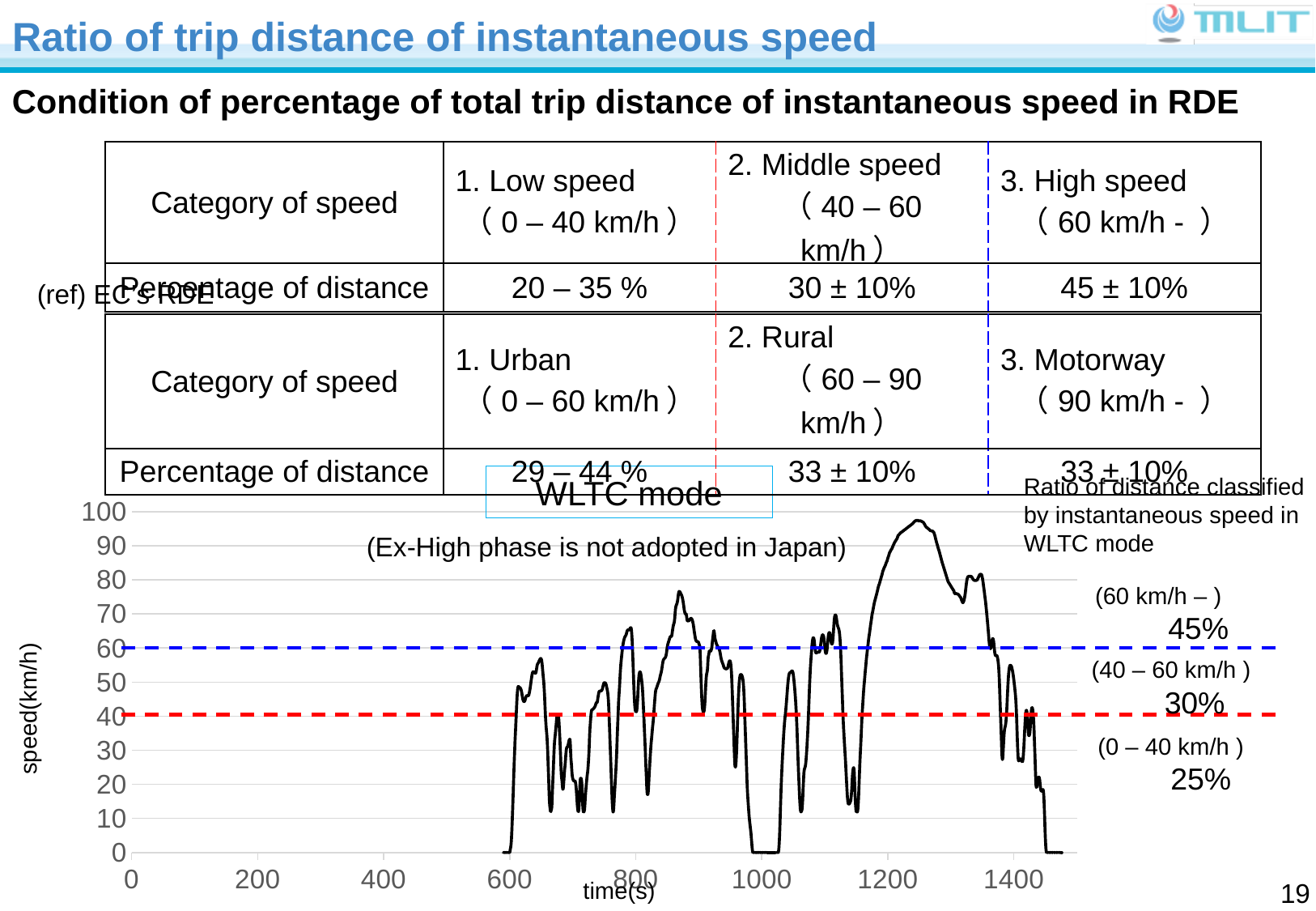
At what speed value is the blue dashed horizontal line drawn on the chart? 60 What is the difference between the ratio of distance for the 60 km/h and above range and the 0 – 40 km/h range in WLTC mode? 20% What is the label of the horizontal axis of the chart? time(s) What is the label of the vertical axis of the chart? speed(km/h) Which speed range has the smallest ratio of distance in WLTC mode according to the chart annotation? (0 – 40 km/h ) According to the annotation on the chart, what is the ratio of distance for the 40 – 60 km/h range in WLTC mode? 30% What kind of chart is shown at the bottom of the slide? line chart According to the annotation on the chart, what is the ratio of distance for the 60 km/h and above range in WLTC mode? 45% Is the peak speed reached in the WLTC mode chart greater or less than 90 km/h? greater Which speed range has the largest ratio of distance in WLTC mode according to the chart annotation? (60 km/h – ) At what speed value is the red dashed horizontal line drawn on the chart? 40 According to the annotation on the chart, what is the ratio of distance for the 0 – 40 km/h range in WLTC mode? 25%